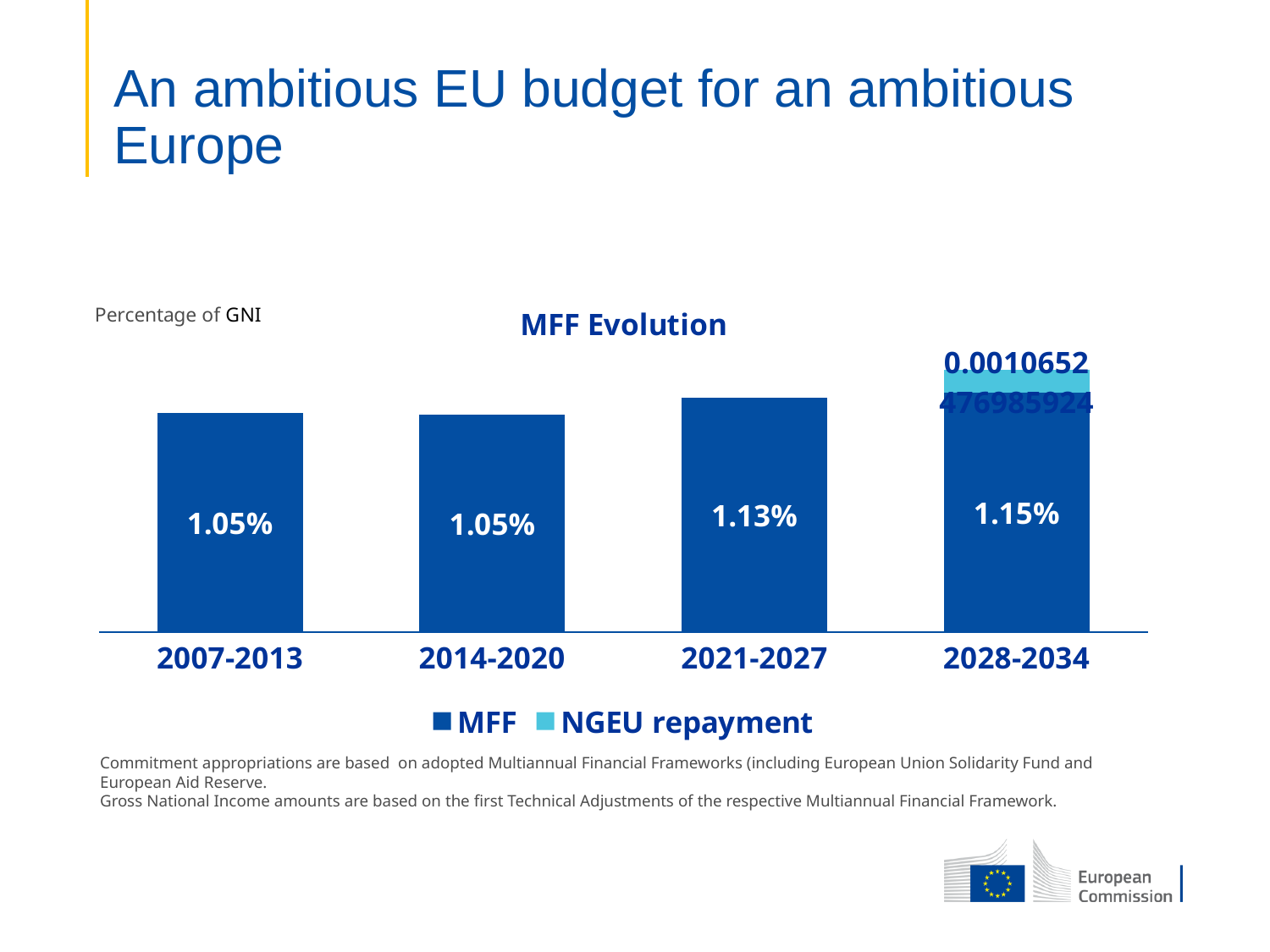
What is the MFF value for 2028-2034? 1.15% How many periods are shown on the x axis of the chart? 4 What kind of chart is shown on the slide? Bar chart What is the MFF value for 2021-2027? 1.13% How many series does the legend list? 2 Do the MFF values rise or fall from 2007-2013 to 2028-2034? Rise What is the MFF value for 2014-2020? 1.05% What is the difference between the MFF value for 2021-2027 and the MFF value for 2014-2020? 0.08% What is the MFF value for 2007-2013? 1.05% Which period has the highest MFF value? 2028-2034 Which is larger, the MFF value for 2021-2027 or the MFF value for 2014-2020? 2021-2027 What is the difference between the MFF value for 2028-2034 and the MFF value for 2007-2013? 0.10%